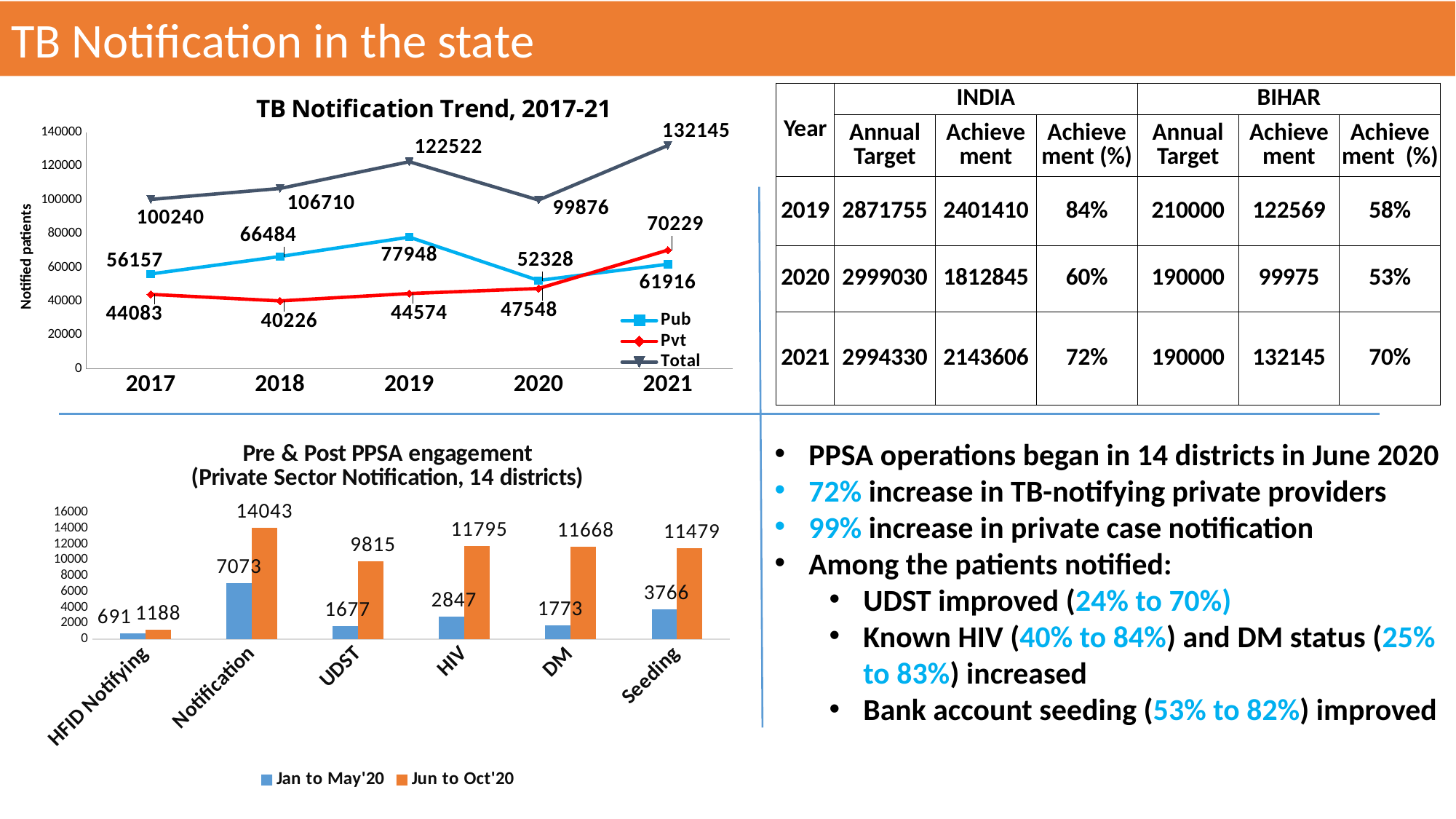
In the 'TB Notification Trend, 2017-21' chart, how many series does the legend list? 3 In the 'Pre & Post PPSA engagement' chart, what is the Jun to Oct'20 value for UDST? 9815 In the 'Pre & Post PPSA engagement' chart, which category has the highest Jun to Oct'20 value? Notification In the 'Pre & Post PPSA engagement' chart, what is the difference between the Jun to Oct'20 and Jan to May'20 values for HIV? 8948 In the 'Pre & Post PPSA engagement' chart, how many categories are shown on the x axis? 6 In the 'TB Notification Trend, 2017-21' chart, what is the Pvt value for 2018? 40226 In the 'TB Notification Trend, 2017-21' chart, which year has the lowest Total value? 2020 What kind of chart is 'Pre & Post PPSA engagement (Private Sector Notification, 14 districts)'? Bar chart In the 'TB Notification Trend, 2017-21' chart, what is the Total value for 2021? 132145 In the 'TB Notification Trend, 2017-21' chart, which year has the highest Pub value? 2019 In the 'TB Notification Trend, 2017-21' chart, which is larger in 2021, Pub or Pvt? Pvt In the 'TB Notification Trend, 2017-21' chart, what is the difference between the Pvt values for 2021 and 2020? 22681